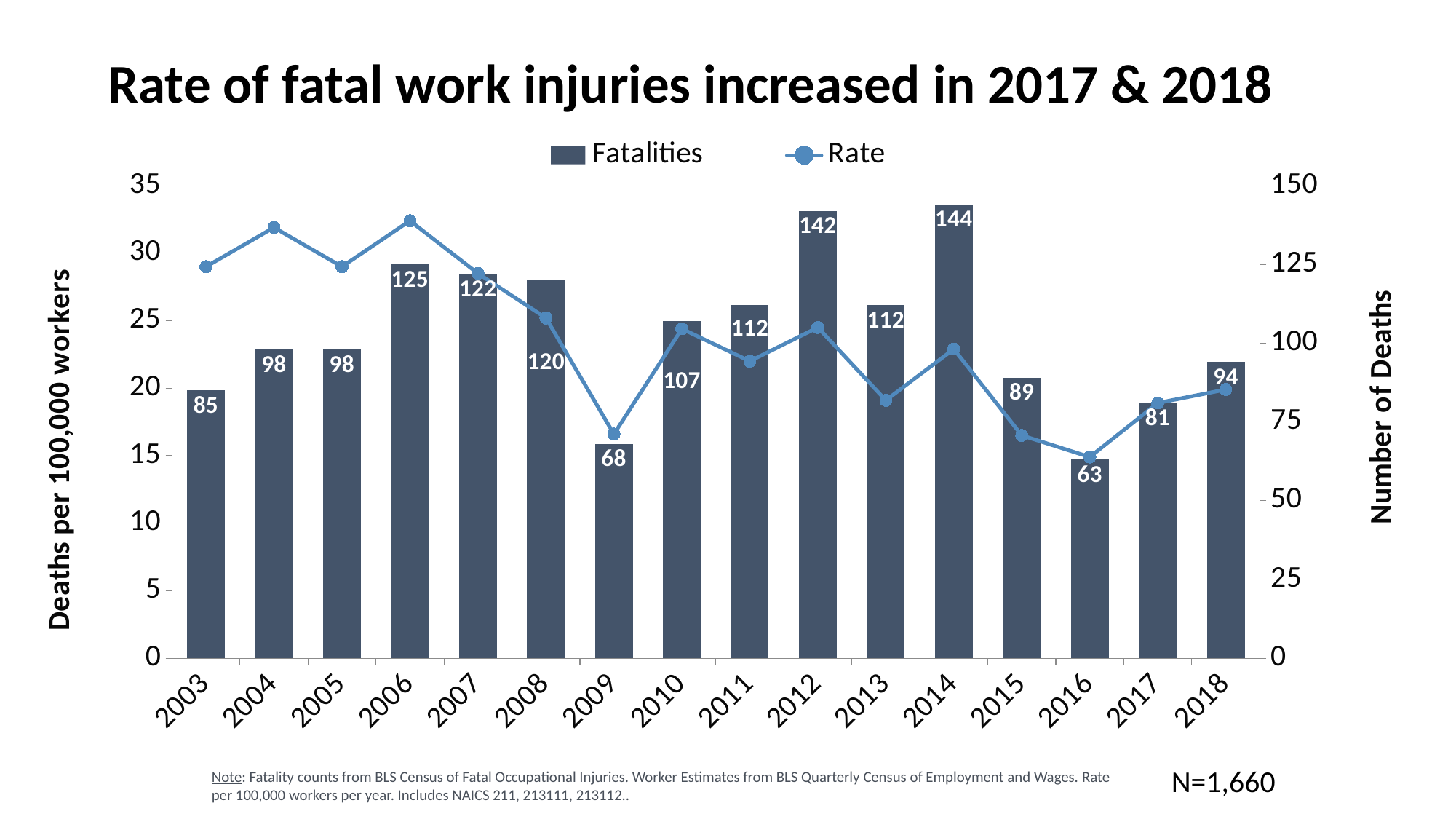
Does the rate rise or fall from 2016 to 2018? rise Which year has the lowest number of fatalities? 2016 How many years are shown on the x axis? 16 Is the rate value for 2006 greater or less than 30 deaths per 100,000 workers? greater Is the rate value for 2009 greater or less than 20 deaths per 100,000 workers? less How many series does the legend list? 2 Which year has the highest number of fatalities? 2014 What is the label of the right-hand vertical axis? Number of Deaths What is the difference in fatalities between 2014 and 2016? 81 What is the number of fatalities in 2009? 68 What is the number of fatalities in 2012? 142 Which year had more fatalities, 2006 or 2008? 2006